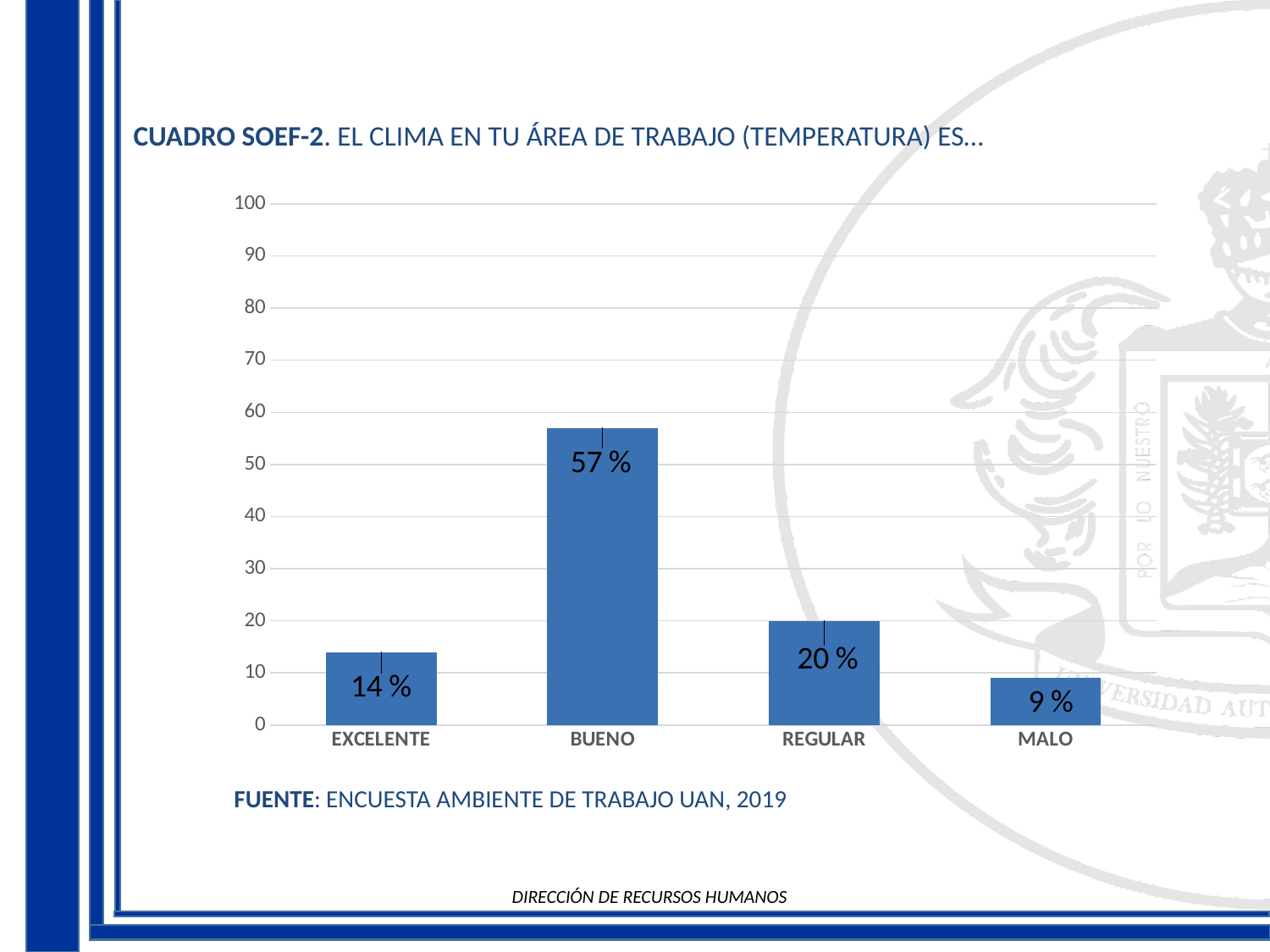
What is the value for BUENO? 57 % Which category has the highest value? BUENO What is the value for MALO? 9 % What is the source cited below the chart? ENCUESTA AMBIENTE DE TRABAJO UAN, 2019 How many categories are shown on the x axis? 4 What kind of chart is shown on the slide? bar chart Which is larger, the value for EXCELENTE or the value for REGULAR? REGULAR What is the value for REGULAR? 20 % Which category has the lowest value? MALO What is the difference between the values for BUENO and REGULAR? 37 % Is the value for BUENO greater or less than 50? greater What is the value for EXCELENTE? 14 %